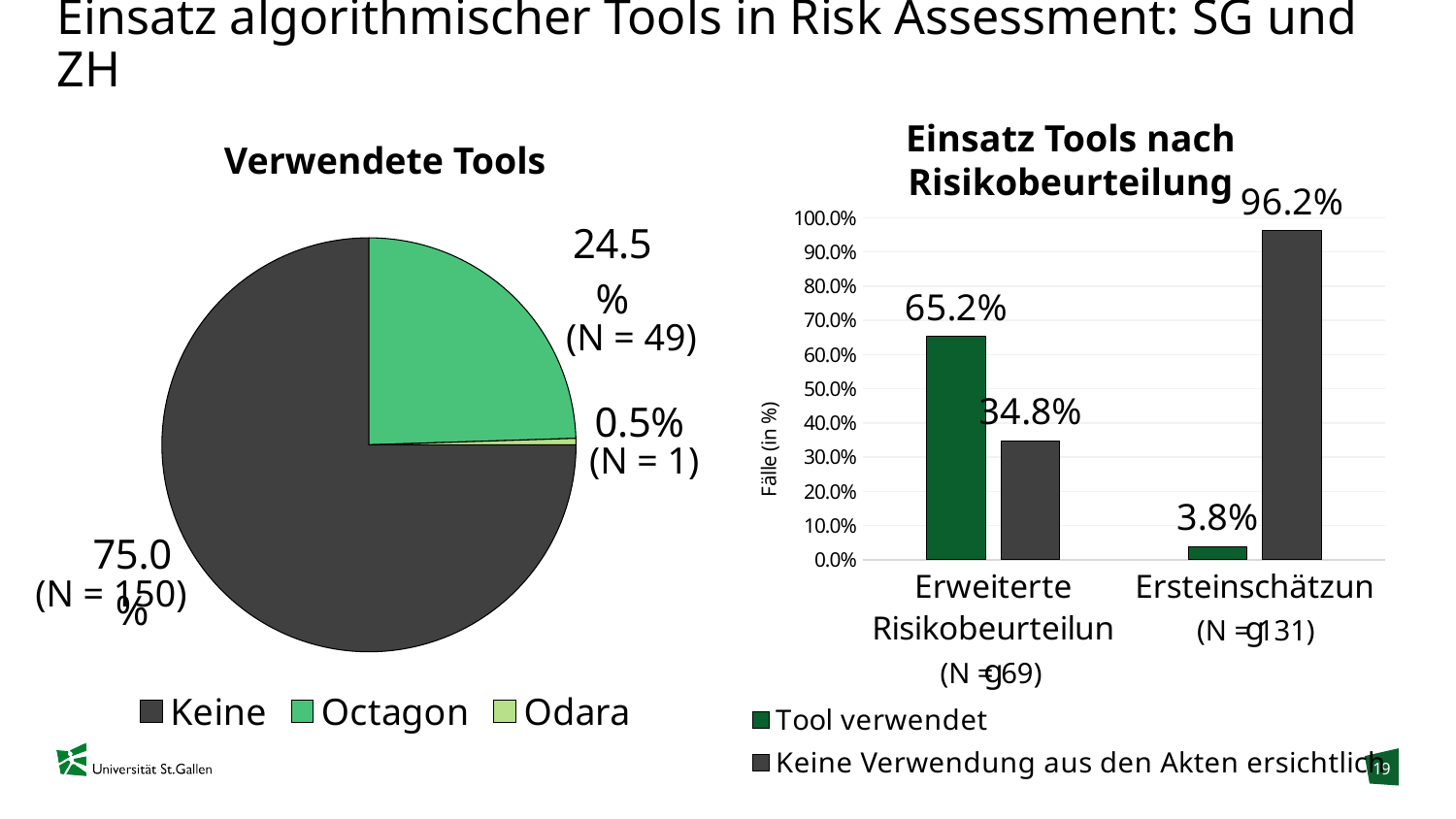
How many categories does the legend of the 'Verwendete Tools' chart list? 3 In the 'Einsatz Tools nach Risikobeurteilung' chart, what is the value of 'Keine Verwendung aus den Akten ersichtlich' for Ersteinschätzung? 96.2% In the 'Verwendete Tools' chart, which tool category has the smallest slice? Odara How many series does the legend of the 'Einsatz Tools nach Risikobeurteilung' chart list? 2 In the 'Einsatz Tools nach Risikobeurteilung' chart, which category has the higher 'Tool verwendet' value? Erweiterte Risikobeurteilung What kind of chart is 'Verwendete Tools'? Pie chart In the 'Verwendete Tools' chart, what percentage is shown for Octagon? 24.5% In the 'Verwendete Tools' chart, what share of the pie does Keine take? 75.0% In the 'Einsatz Tools nach Risikobeurteilung' chart, what is the difference between 'Tool verwendet' for Erweiterte Risikobeurteilung and for Ersteinschätzung? 61.4% In the 'Einsatz Tools nach Risikobeurteilung' chart, what is the value of 'Tool verwendet' for Erweiterte Risikobeurteilung? 65.2% What kind of chart is 'Einsatz Tools nach Risikobeurteilung'? Bar chart In the 'Verwendete Tools' chart, what is the N value shown for Odara? N = 1